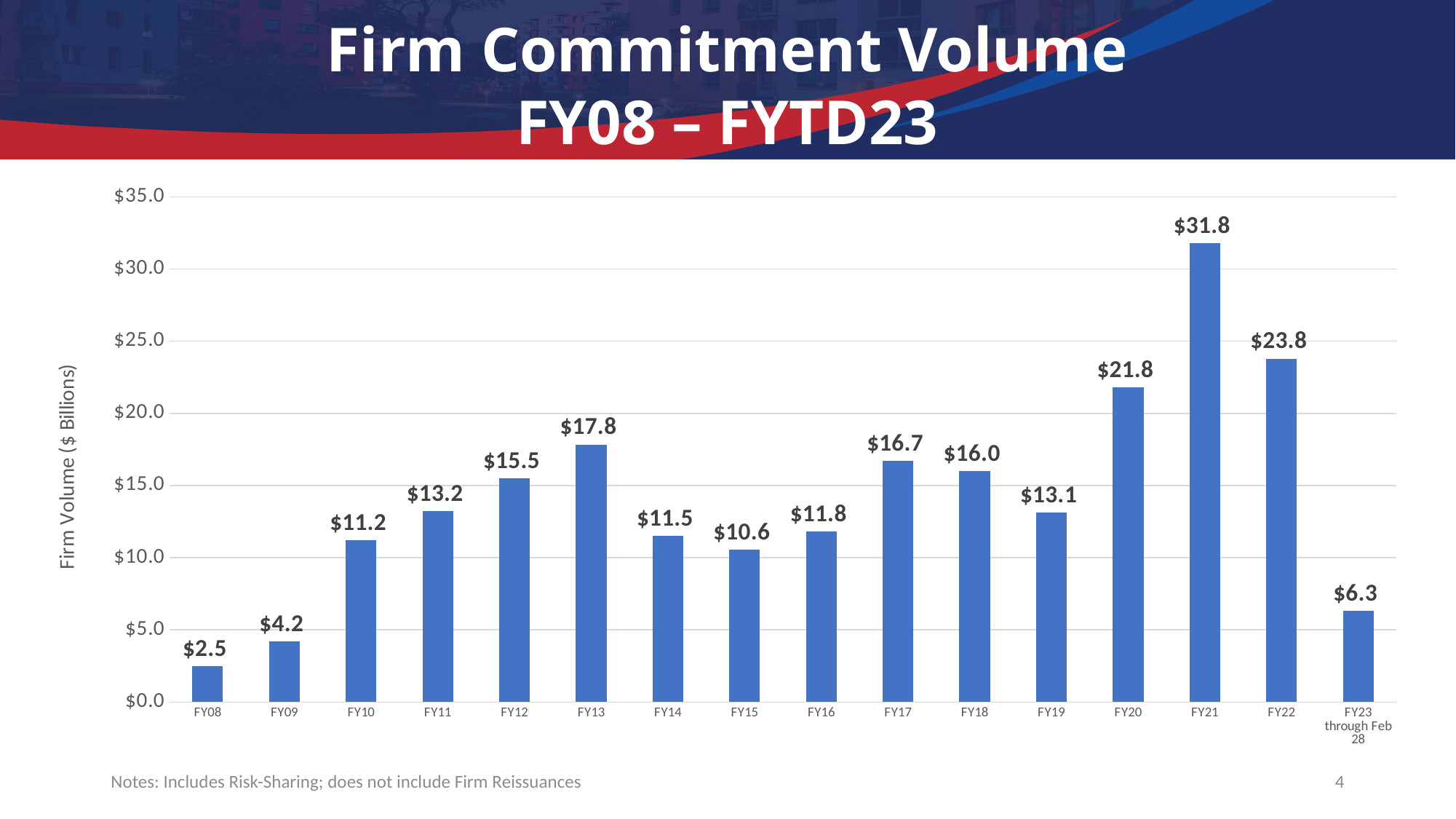
Which has a larger firm commitment volume, FY17 or FY18? FY17 What is the firm commitment volume for FY23 through Feb 28? $6.3 What is the label of the y axis? Firm Volume ($ Billions) What is the firm commitment volume for FY08? $2.5 Which fiscal year has the highest firm commitment volume? FY21 How many fiscal year categories are shown on the x axis? 16 What kind of chart is shown on the slide? Bar chart What is the difference between the firm commitment volume in FY21 and FY22? $8.0 What is the firm commitment volume for FY21? $31.8 Is the value for FY20 greater or less than $20.0? greater Which fiscal year has the lowest firm commitment volume? FY08 Do the values rise or fall from FY13 to FY15? Fall